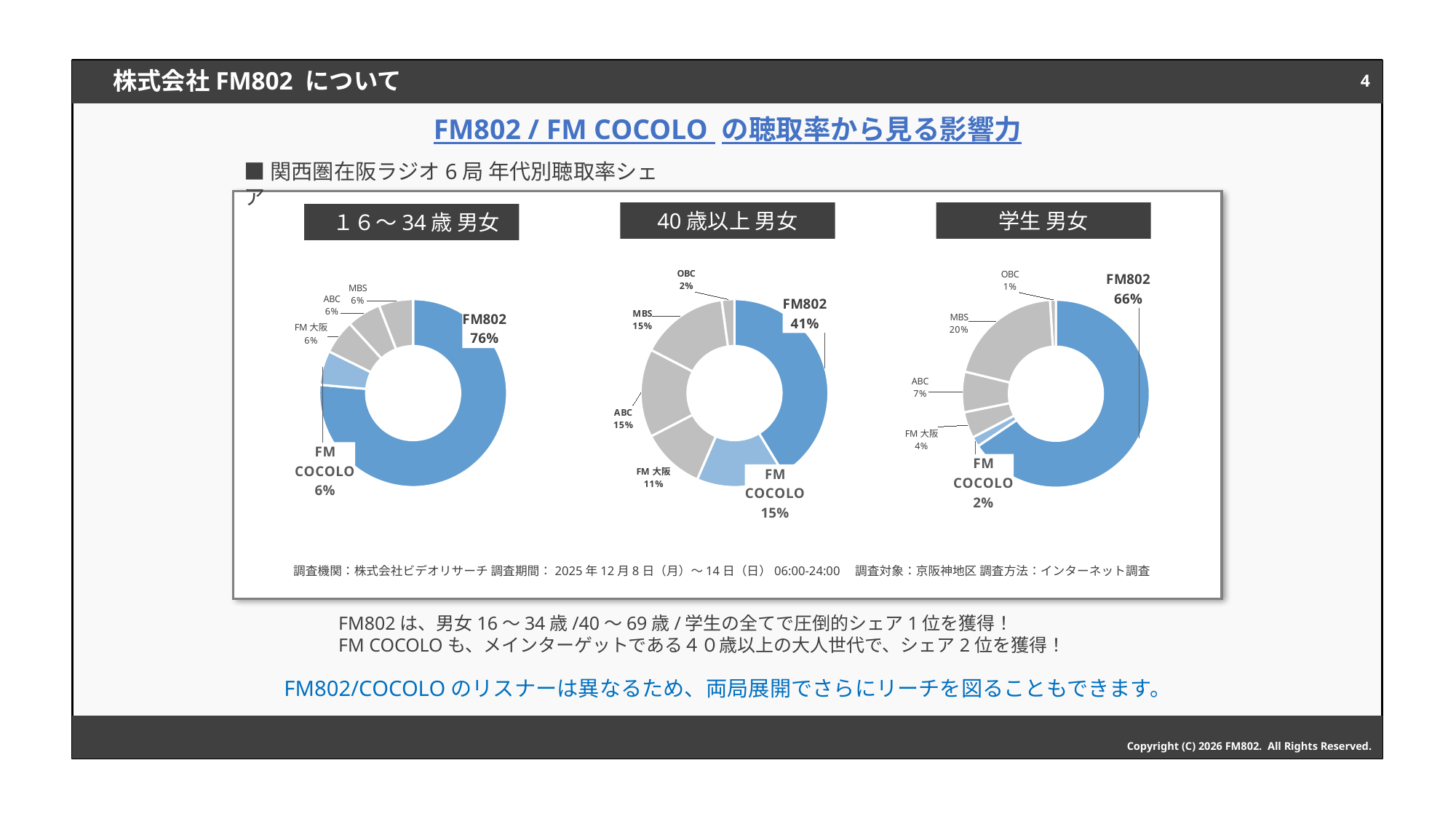
In the 40歳以上 男女 chart, what share does FM COCOLO have? 15% How many charts are shown on the slide? 3 In the 学生 男女 chart, which is larger, the share for ABC or the share for FM大阪? ABC In the 40歳以上 男女 chart, what share does OBC have? 2% How many stations are labelled in the 40歳以上 男女 chart? 6 In the 学生 男女 chart, what is the difference between FM802's share and MBS's share? 46% In the 40歳以上 男女 chart, what is the difference between FM802's share and FM COCOLO's share? 26% In the 40歳以上 男女 chart, which station has the largest share? FM802 In the 学生 男女 chart, which station has the smallest share? OBC In the 学生 男女 chart, what share does MBS have? 20% What type of chart is used for the 16～34歳 男女 data? Donut (pie) chart In the 16～34歳 男女 chart, what share does FM802 have? 76%